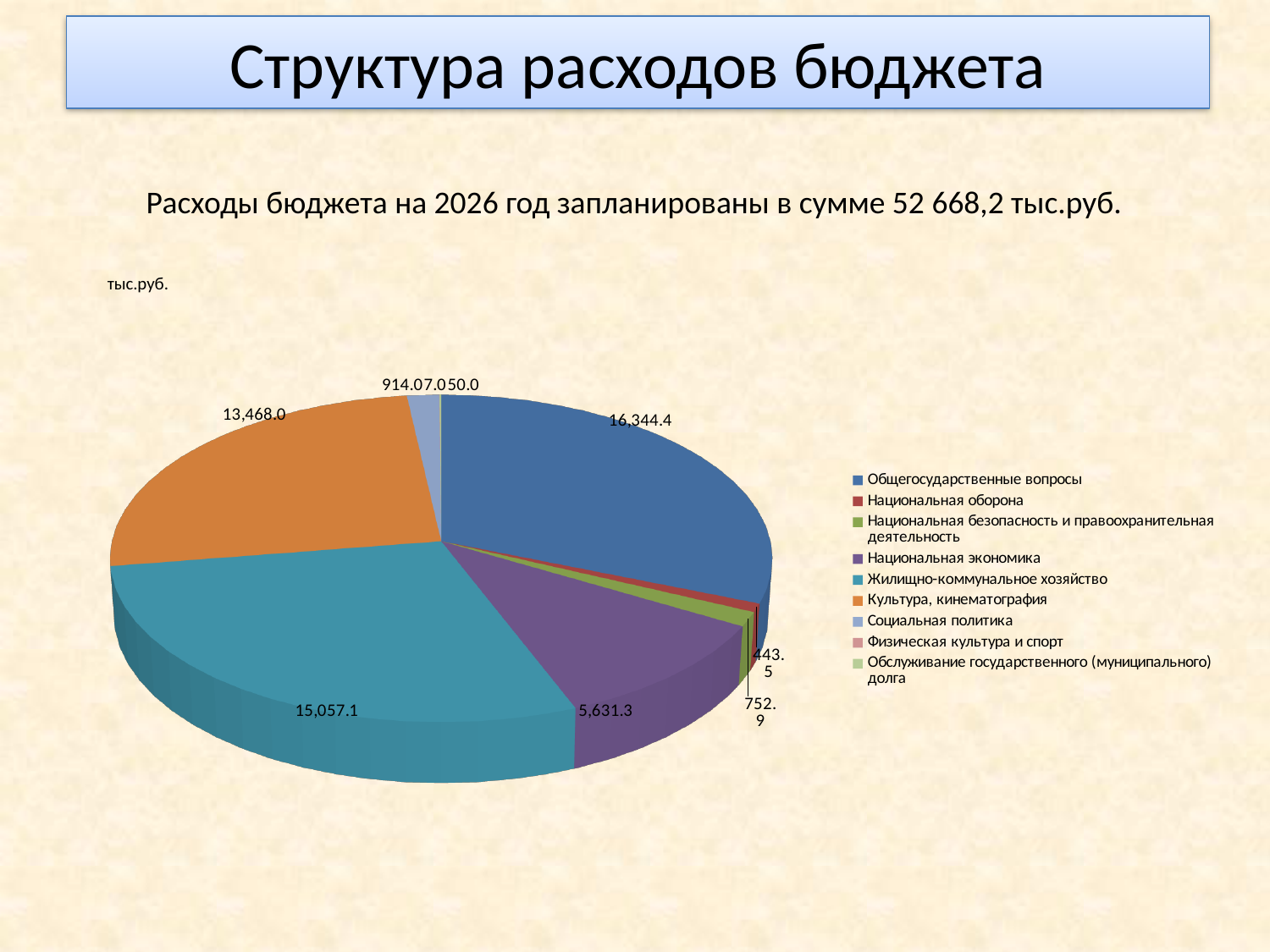
What kind of chart is shown on the slide? pie chart What is the value for Общегосударственные вопросы? 16,344.4 What is the value for Культура, кинематография? 13,468.0 How many categories does the legend list? 9 What unit is indicated above the chart? тыс.руб. Which category has the smallest value in the pie chart? Физическая культура и спорт Which category has the largest slice of the pie? Общегосударственные вопросы What is the value for Жилищно-коммунальное хозяйство? 15,057.1 What is the difference between Общегосударственные вопросы and Жилищно-коммунальное хозяйство? 1,287.3 Which is larger: Жилищно-коммунальное хозяйство or Культура, кинематография? Жилищно-коммунальное хозяйство What is the value for Социальная политика? 914.0 What is the value for Национальная экономика? 5,631.3